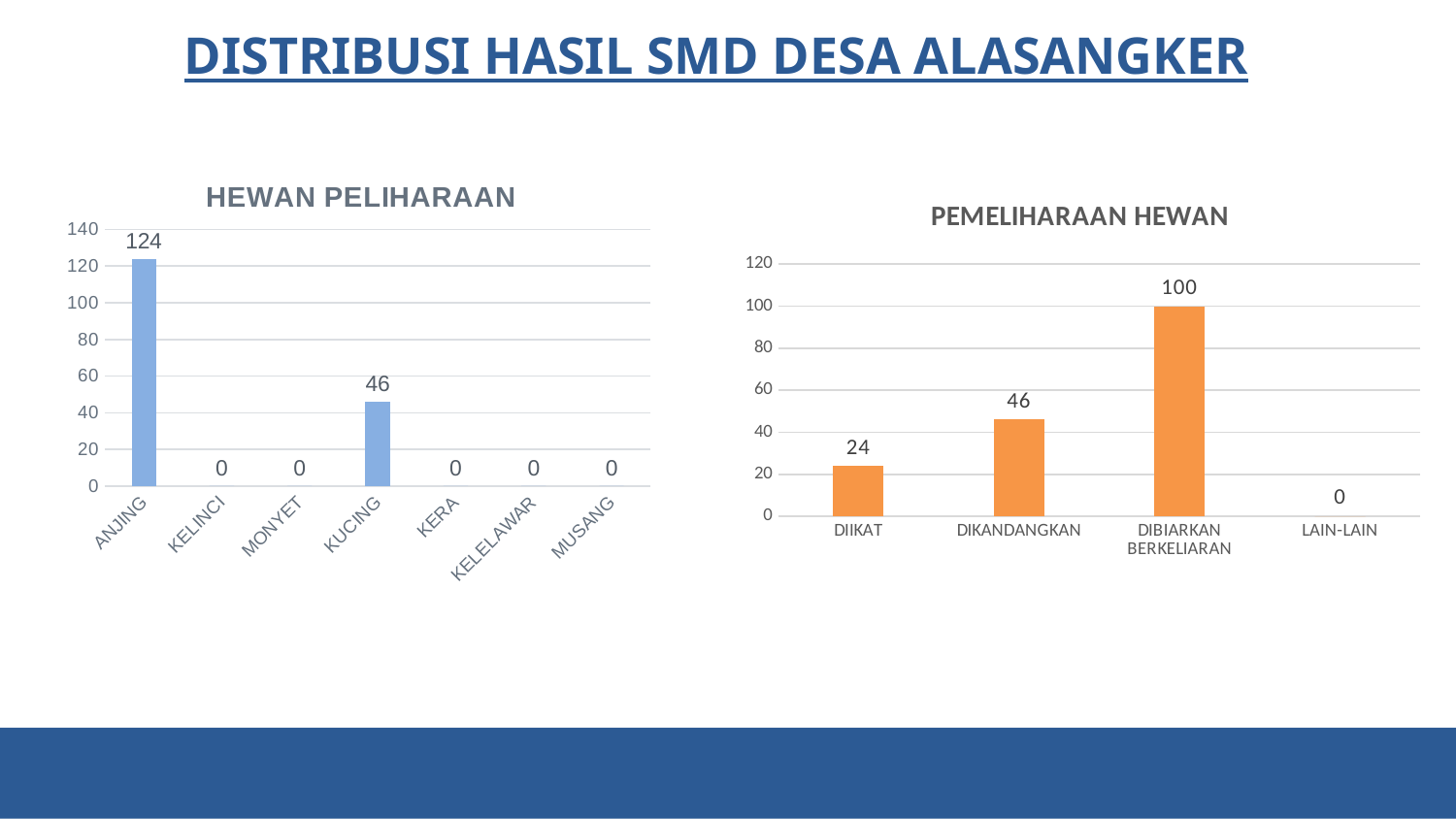
In the PEMELIHARAAN HEWAN chart, what is the value for DIBIARKAN BERKELIARAN? 100 In the HEWAN PELIHARAAN chart, what is the value for ANJING? 124 In the PEMELIHARAAN HEWAN chart, what is the difference between DIBIARKAN BERKELIARAN and DIKANDANGKAN? 54 In the PEMELIHARAAN HEWAN chart, which is larger, DIKANDANGKAN or DIIKAT? DIKANDANGKAN In the PEMELIHARAAN HEWAN chart, what is the value for DIIKAT? 24 In the HEWAN PELIHARAAN chart, what is the value for KELELAWAR? 0 In the HEWAN PELIHARAAN chart, which category has the highest value? ANJING In the HEWAN PELIHARAAN chart, what is the difference between the values for ANJING and KUCING? 78 In the HEWAN PELIHARAAN chart, how many categories are shown on the x axis? 7 In the HEWAN PELIHARAAN chart, what is the value for KUCING? 46 In the PEMELIHARAAN HEWAN chart, which category has the lowest value? LAIN-LAIN What kind of chart is the PEMELIHARAAN HEWAN chart? Bar chart